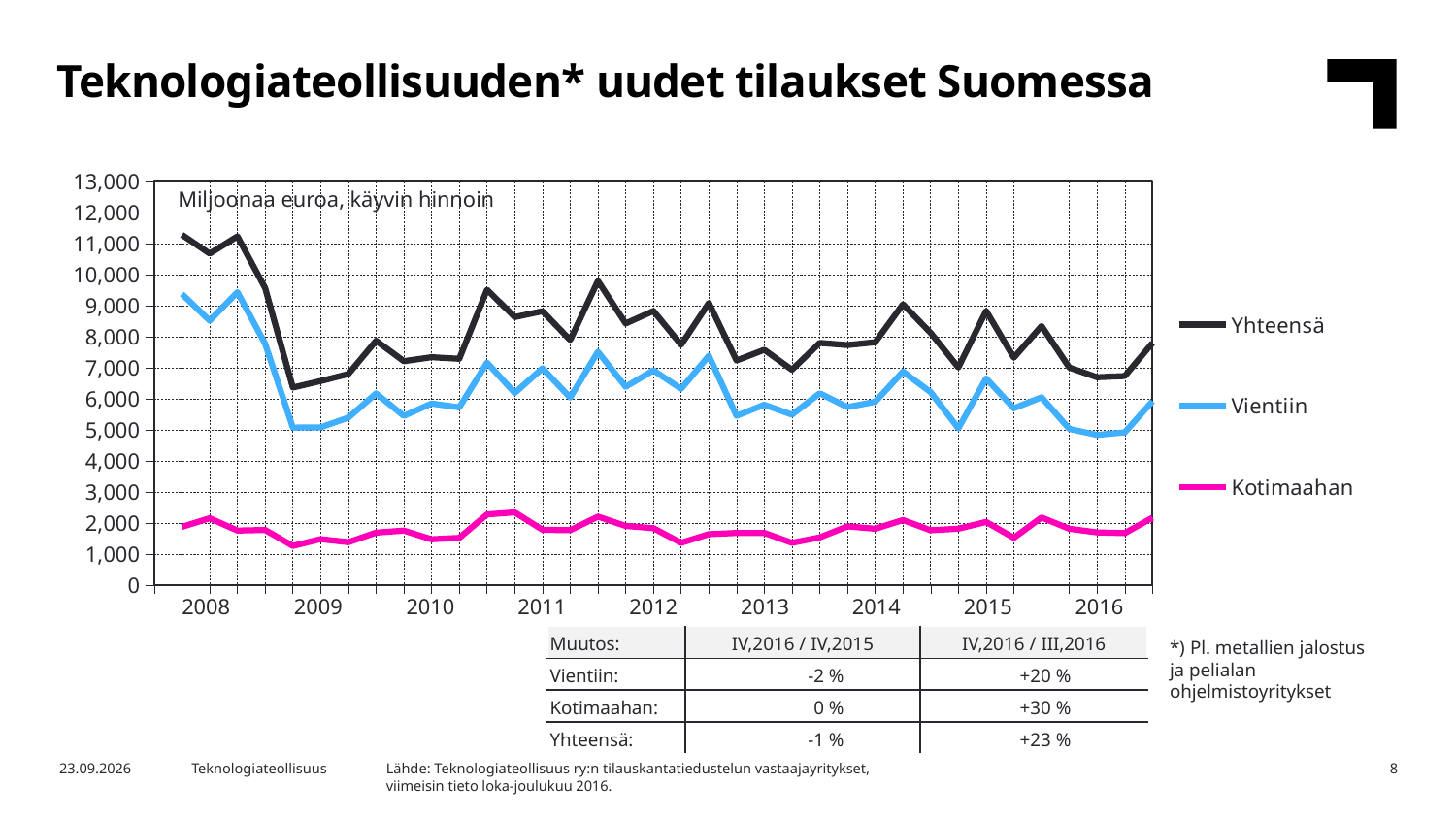
Is the value for Yhteensä at the start of 2008 greater or less than 10,000? greater What kind of chart is shown on the slide? Line chart How many years are labelled on the x axis? 9 Is the value for Yhteensä at the end of 2016 greater or less than 9,000? less Which series is plotted with the highest values throughout the chart? Yhteensä What unit is stated inside the chart area? Miljoonaa euroa, käyvin hinnoin Is the value for Vientiin at the start of 2008 greater or less than 8,000? greater Which series has the larger value in 2016, Vientiin or Kotimaahan? Vientiin Which series is plotted with the lowest values throughout the chart? Kotimaahan Does the Yhteensä series overall rise or fall from 2008 to 2016? Fall How many series does the legend list? 3